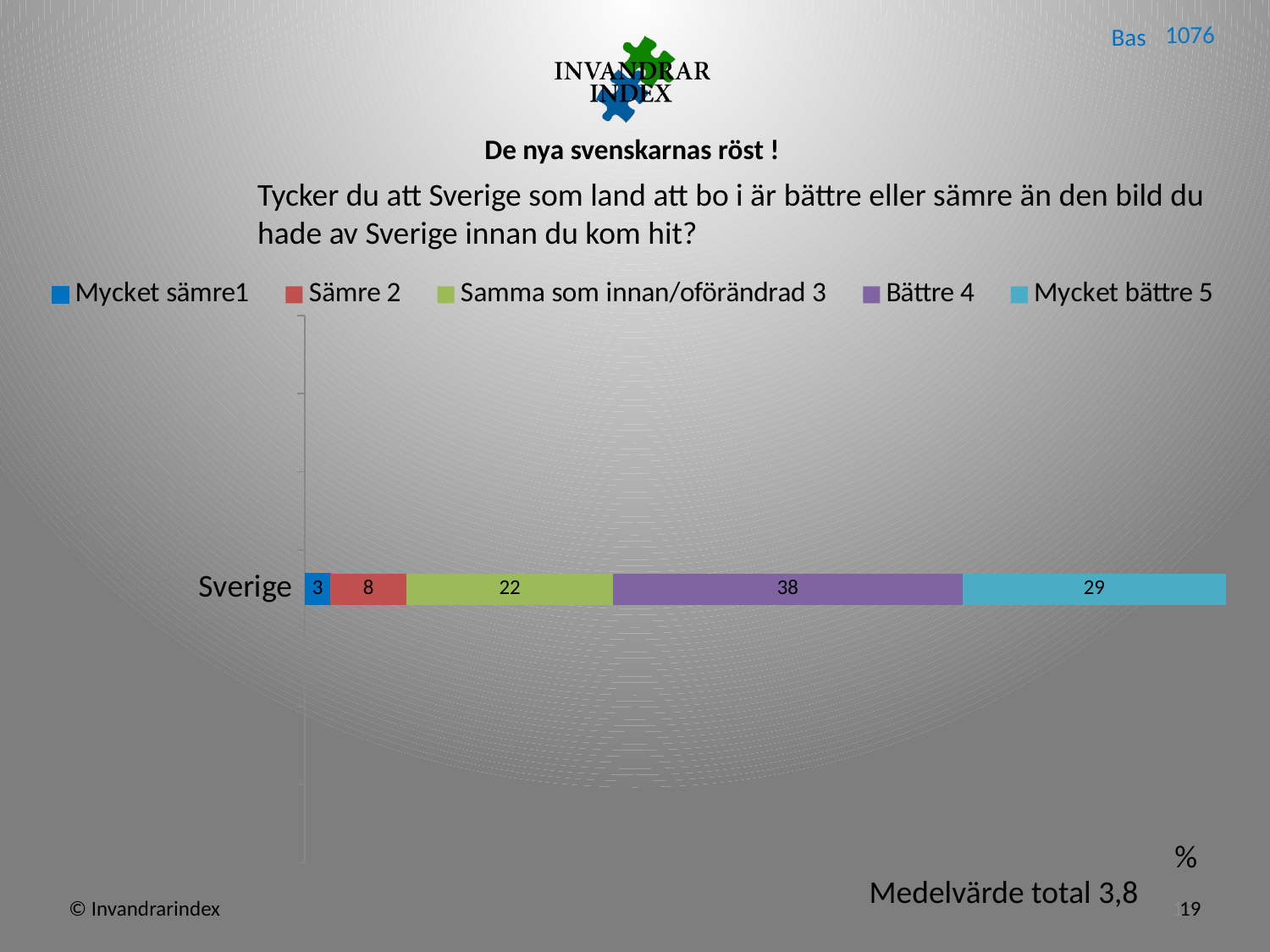
Which is larger for Sverige: 'Samma som innan/oförändrad 3' or 'Sämre 2'? Samma som innan/oförändrad 3 How many series does the legend list? 5 Which series has the largest segment in the Sverige bar? Bättre 4 Which series has the smallest segment in the Sverige bar? Mycket sämre1 What kind of chart is shown on the slide? Stacked bar chart What is the value for 'Samma som innan/oförändrad 3' in the Sverige bar? 22 What is the value for 'Sämre 2' in the Sverige bar? 8 What is the value for 'Mycket bättre 5' in the Sverige bar? 29 What is the difference between the 'Bättre 4' and 'Mycket bättre 5' values for Sverige? 9 What is the total of the stacked Sverige bar? 100 What is the value for 'Mycket sämre1' in the Sverige bar? 3 What is the value for 'Bättre 4' in the Sverige bar? 38